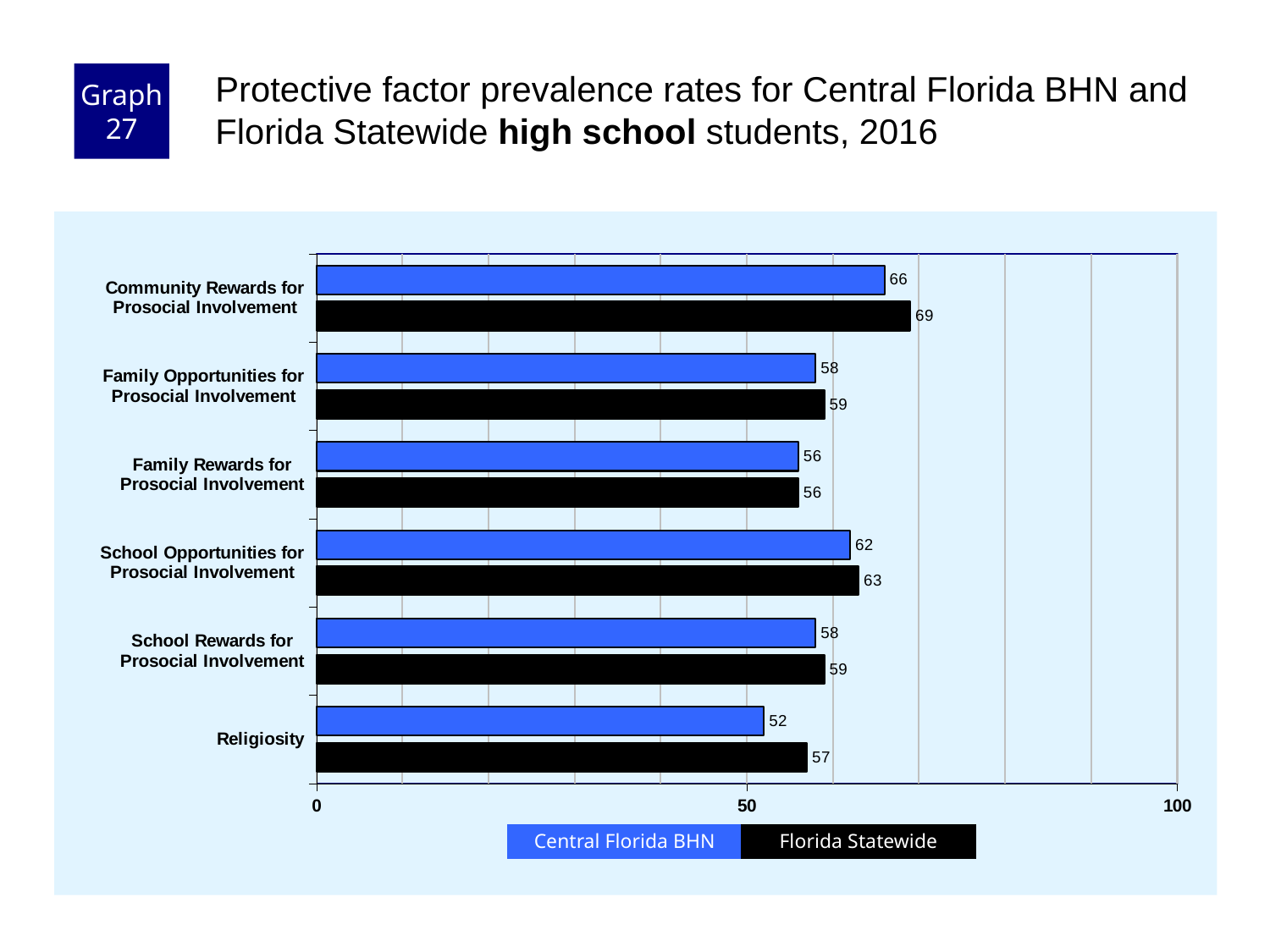
How many series does the legend list? 2 Which category has the highest Florida Statewide value? Community Rewards for Prosocial Involvement Is the Central Florida BHN value for Community Rewards for Prosocial Involvement greater or less than 50? greater What is the Central Florida BHN value for Community Rewards for Prosocial Involvement? 66 What is the difference between the Florida Statewide and Central Florida BHN values for Religiosity? 5 Which is larger for Religiosity: the Central Florida BHN value or the Florida Statewide value? Florida Statewide Which category has the lowest Central Florida BHN value? Religiosity How many protective factor categories are shown on the chart? 6 What is the difference between the Florida Statewide and Central Florida BHN values for Community Rewards for Prosocial Involvement? 3 What is the Florida Statewide value for School Opportunities for Prosocial Involvement? 63 What is the Florida Statewide value for Religiosity? 57 What kind of chart is shown on the slide? Bar chart